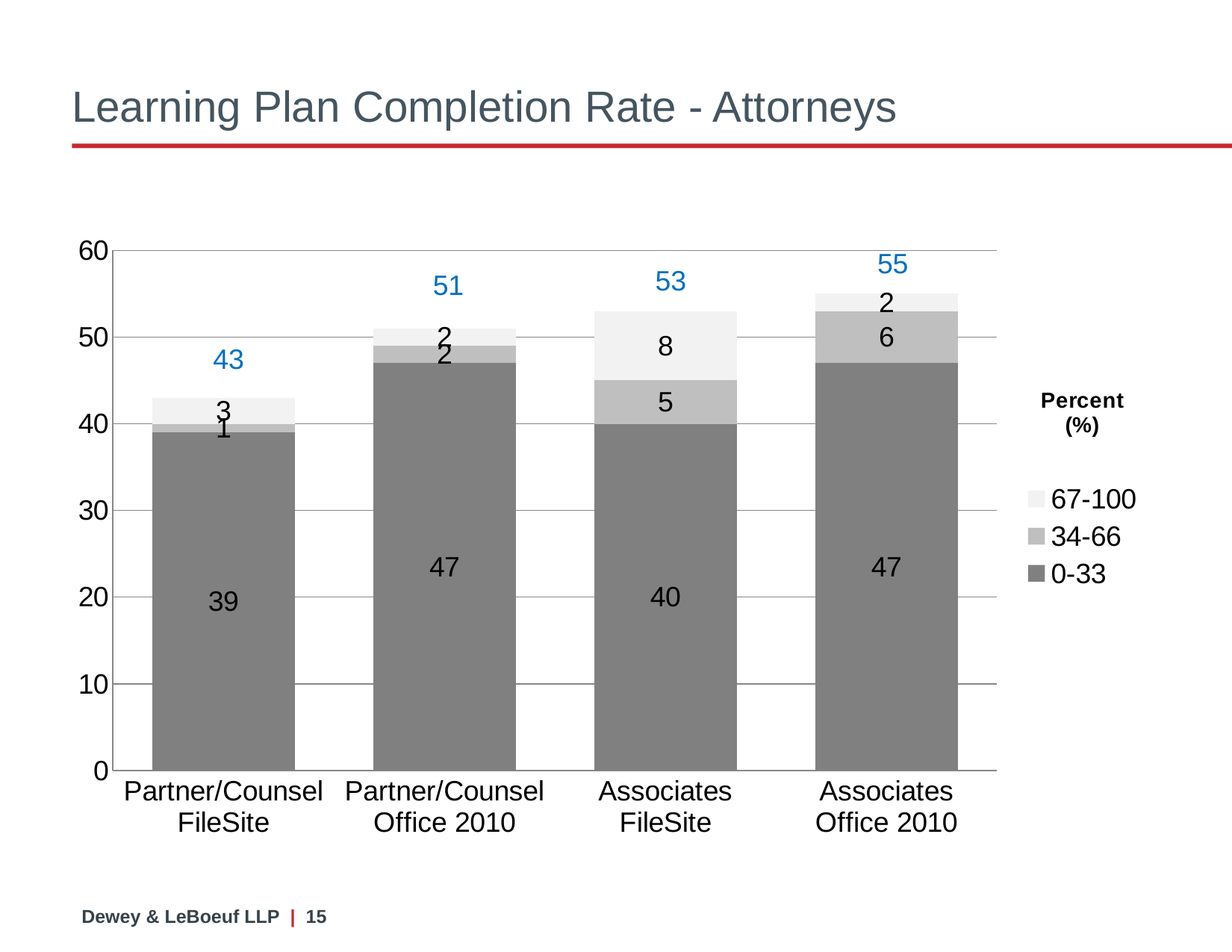
Which is larger, the 67-100 segment for Associates FileSite or the 67-100 segment for Partner/Counsel Office 2010? Associates FileSite What is the value of the 34-66 segment for Associates Office 2010? 6 What is the total of the stacked bar for Partner/Counsel FileSite? 43 Do the stacked bar totals rise or fall from left to right across the x axis? Rise What kind of chart is shown on the slide? Stacked bar chart Which category has the lowest stacked bar total? Partner/Counsel FileSite What is the value of the 67-100 segment for Associates FileSite? 8 How many series does the legend list? 3 What is the difference between the stacked bar totals for Associates Office 2010 and Partner/Counsel FileSite? 12 How many categories are shown on the x axis? 4 What is the value of the 0-33 segment for Associates FileSite? 40 Which category has the highest stacked bar total? Associates Office 2010